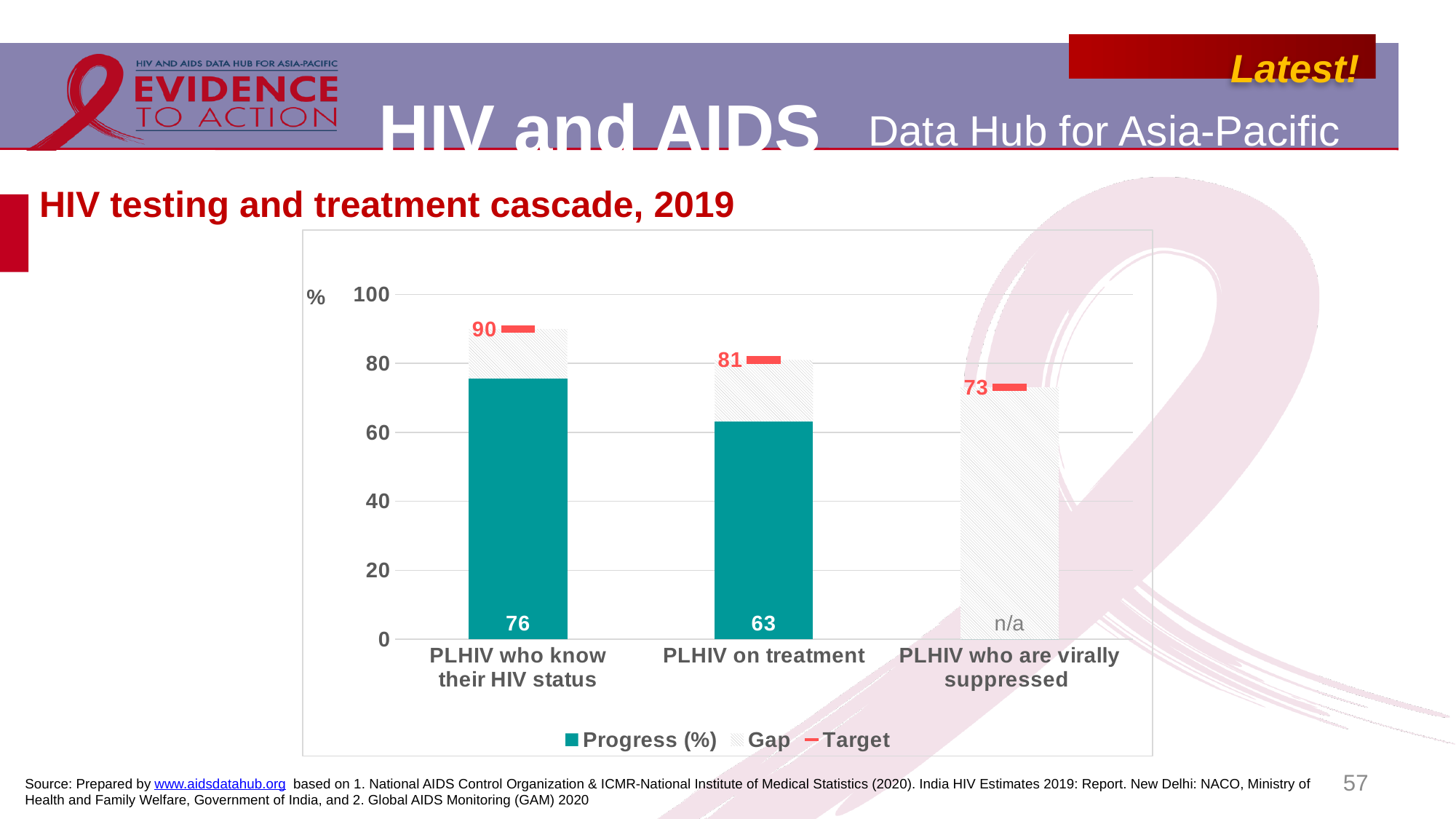
Which category has the lowest Target value? PLHIV who are virally suppressed What kind of chart is shown on the slide? Bar chart What is the Target value for PLHIV who know their HIV status? 90 What is the Progress (%) value for PLHIV who know their HIV status? 76 What is the Target value for PLHIV who are virally suppressed? 73 What Progress (%) value is shown for PLHIV who are virally suppressed? n/a What is the difference between the Target and Progress (%) values for PLHIV on treatment? 18 Which category has the highest Target value? PLHIV who know their HIV status What is the difference between the Target and Progress (%) values for PLHIV who know their HIV status? 14 What is the Target value for PLHIV on treatment? 81 What is the Progress (%) value for PLHIV on treatment? 63 How many series does the legend list? 3